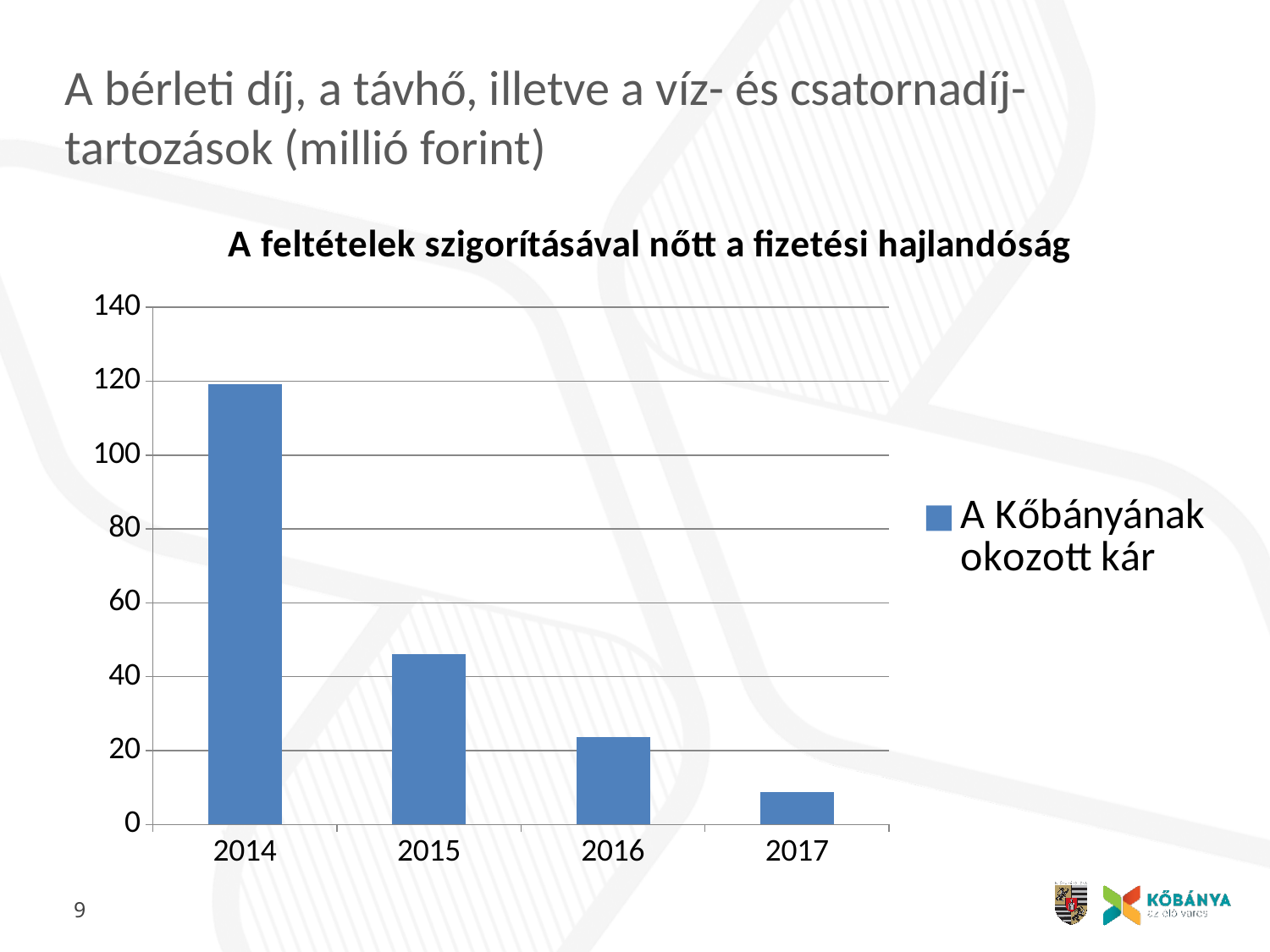
Is the value for 2014 greater or less than 100? greater What is the title of the chart? A feltételek szigorításával nőtt a fizetési hajlandóság How many series does the chart legend list? 1 Is the value for 2016 greater or less than 20? greater Which is larger, the value for 2015 or the value for 2016? 2015 How many years are shown on the x axis of the chart? 4 Which year has the lowest value for A Kőbányának okozott kár? 2017 Is the value for 2015 greater or less than 60? less Which year has the highest value for A Kőbányának okozott kár? 2014 What kind of chart is shown on the slide? bar chart Do the values rise or fall from 2014 to 2017? fall